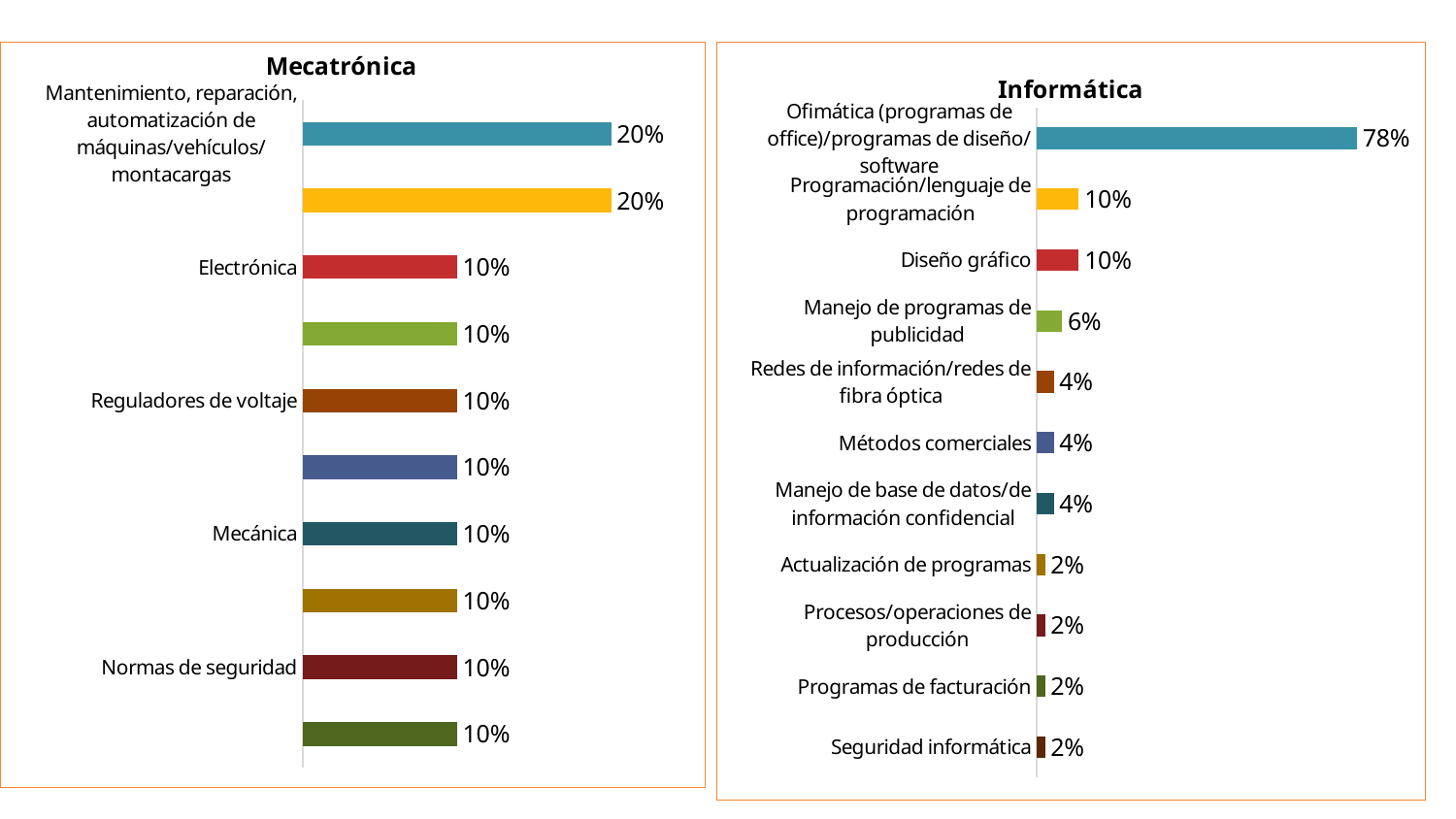
In the Informática chart, what is the difference between Ofimática (programas de office)/programas de diseño/software and Programación/lenguaje de programación? 68% How many bars are plotted in the Informática chart? 11 In the Mecatrónica chart, what is the value for Mantenimiento, reparación, automatización de máquinas/vehículos/montacargas? 20% In the Informática chart, what is the value for Seguridad informática? 2% In the Informática chart, what is the value for Ofimática (programas de office)/programas de diseño/software? 78% In the Informática chart, what is the value for Manejo de programas de publicidad? 6% In the Informática chart, which category has the highest value? Ofimática (programas de office)/programas de diseño/software In the Mecatrónica chart, what is the value for Reguladores de voltaje? 10% What is the title of the chart on the right side of the slide? Informática What type of chart is the Mecatrónica chart? Bar chart In the Mecatrónica chart, what is the difference between Mantenimiento, reparación, automatización de máquinas/vehículos/montacargas and Electrónica? 10% In the Informática chart, which is larger: Diseño gráfico or Redes de información/redes de fibra óptica? Diseño gráfico